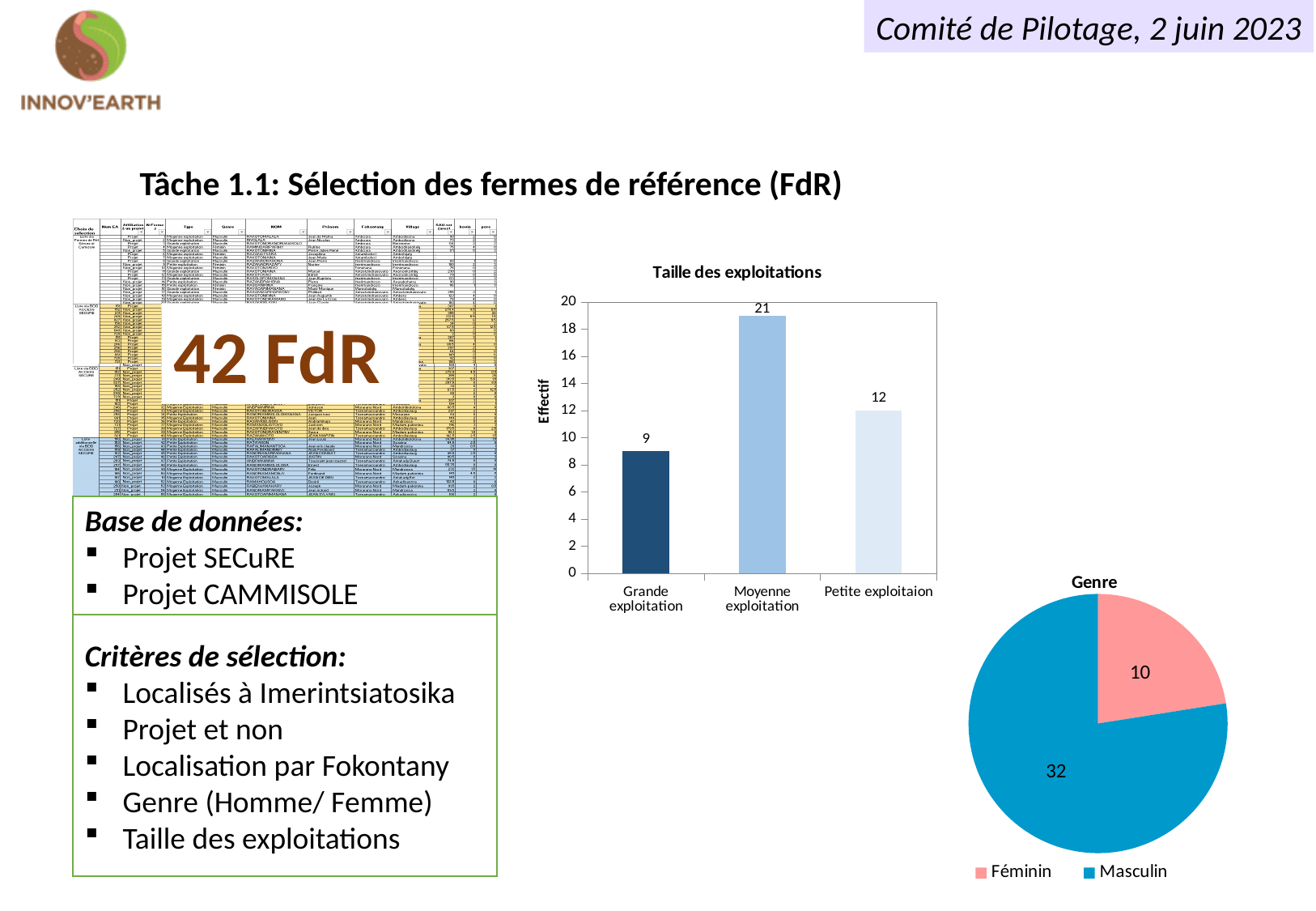
In the 'Taille des exploitations' chart, which category has the lowest value? Grande exploitation In the 'Taille des exploitations' chart, what is the value for Grande exploitation? 9 What kind of chart is the 'Taille des exploitations' chart? bar chart In the 'Genre' pie chart, what is the value for Féminin? 10 In the 'Taille des exploitations' chart, is the value for Grande exploitation greater or less than 10? less In the 'Taille des exploitations' chart, how many categories are shown on the x axis? 3 In the 'Genre' pie chart, what is the value for Masculin? 32 In the 'Taille des exploitations' chart, what is the difference between the values for Petite exploitaion and Grande exploitation? 3 In the 'Taille des exploitations' chart, what is the value for Petite exploitaion? 12 In the 'Genre' pie chart, which slice is larger, Féminin or Masculin? Masculin In the 'Taille des exploitations' chart, which category has the highest value? Moyenne exploitation In the 'Taille des exploitations' chart, what is the data label shown for Moyenne exploitation? 21